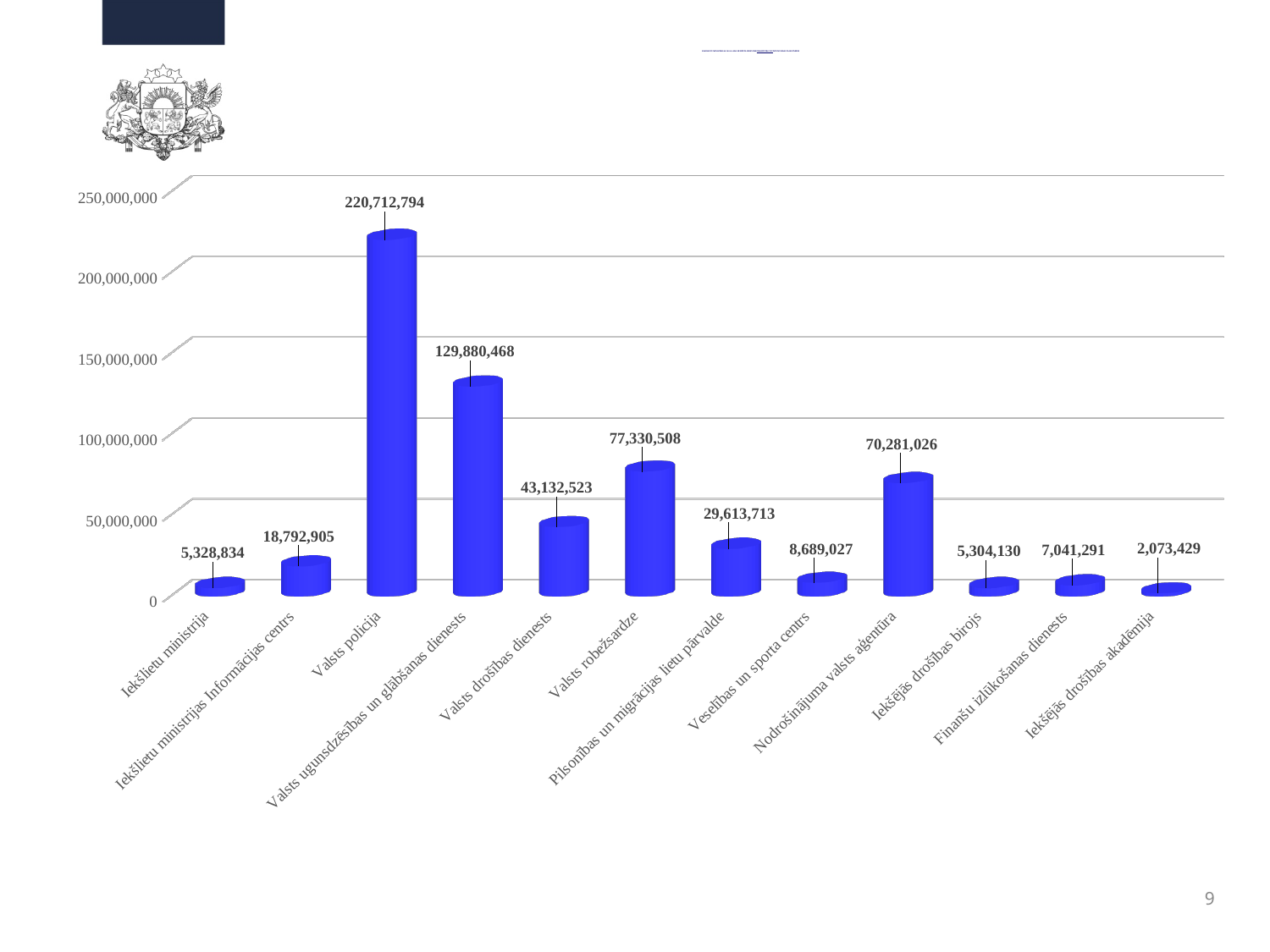
Which category has the lowest value? Iekšējās drošības akadēmija What is the value for Valsts policija? 220,712,794 What is the difference between the values for Valsts policija and Valsts ugunsdzēsības un glābšanas dienests? 90,832,326 What is the value for Nodrošinājuma valsts aģentūra? 70,281,026 What is the value for Iekšējās drošības akadēmija? 2,073,429 What is the difference between the values for Valsts robežsardze and Nodrošinājuma valsts aģentūra? 7,049,482 What is the value for Valsts robežsardze? 77,330,508 Which category has the highest value? Valsts policija How many categories are shown on the x axis? 12 What kind of chart is shown on the slide? Bar chart Is the value for Valsts ugunsdzēsības un glābšanas dienests greater or less than 100,000,000? greater Which is larger, the value for Valsts drošības dienests or the value for Pilsonības un migrācijas lietu pārvalde? Valsts drošības dienests